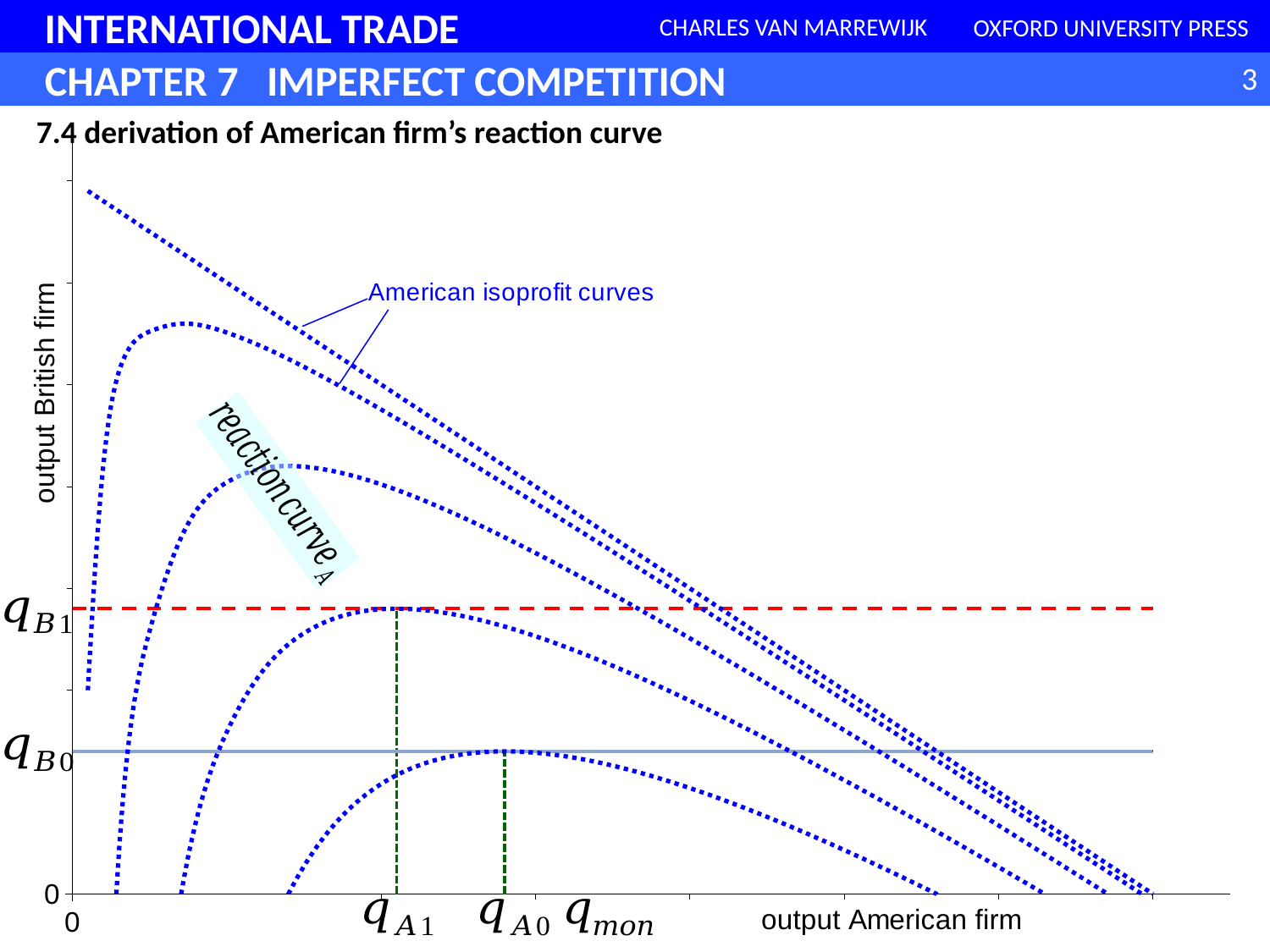
What is the title of the chart on the slide? 7.4 derivation of American firm's reaction curve What kind of chart is shown on the slide? line chart Which labelled British output level is drawn as a red dashed horizontal line? q_B1 Which is larger on the vertical axis, q_B1 or q_B0? q_B1 At the British output level q_B1, what American output does the dashed vertical line mark on the horizontal axis? q_A1 Which is larger on the horizontal axis, q_A0 or q_mon? q_mon Which is larger on the horizontal axis, q_A1 or q_A0? q_A0 Moving from left to right along the horizontal axis, does the isoprofit curve that peaks at q_B1 rise or fall after reaching q_A1? fall What are the dotted blue curves in the chart labelled as? American isoprofit curves What value is printed at the origin of the horizontal axis? 0 At the British output level q_B0, what American output does the dashed vertical line mark on the horizontal axis? q_A0